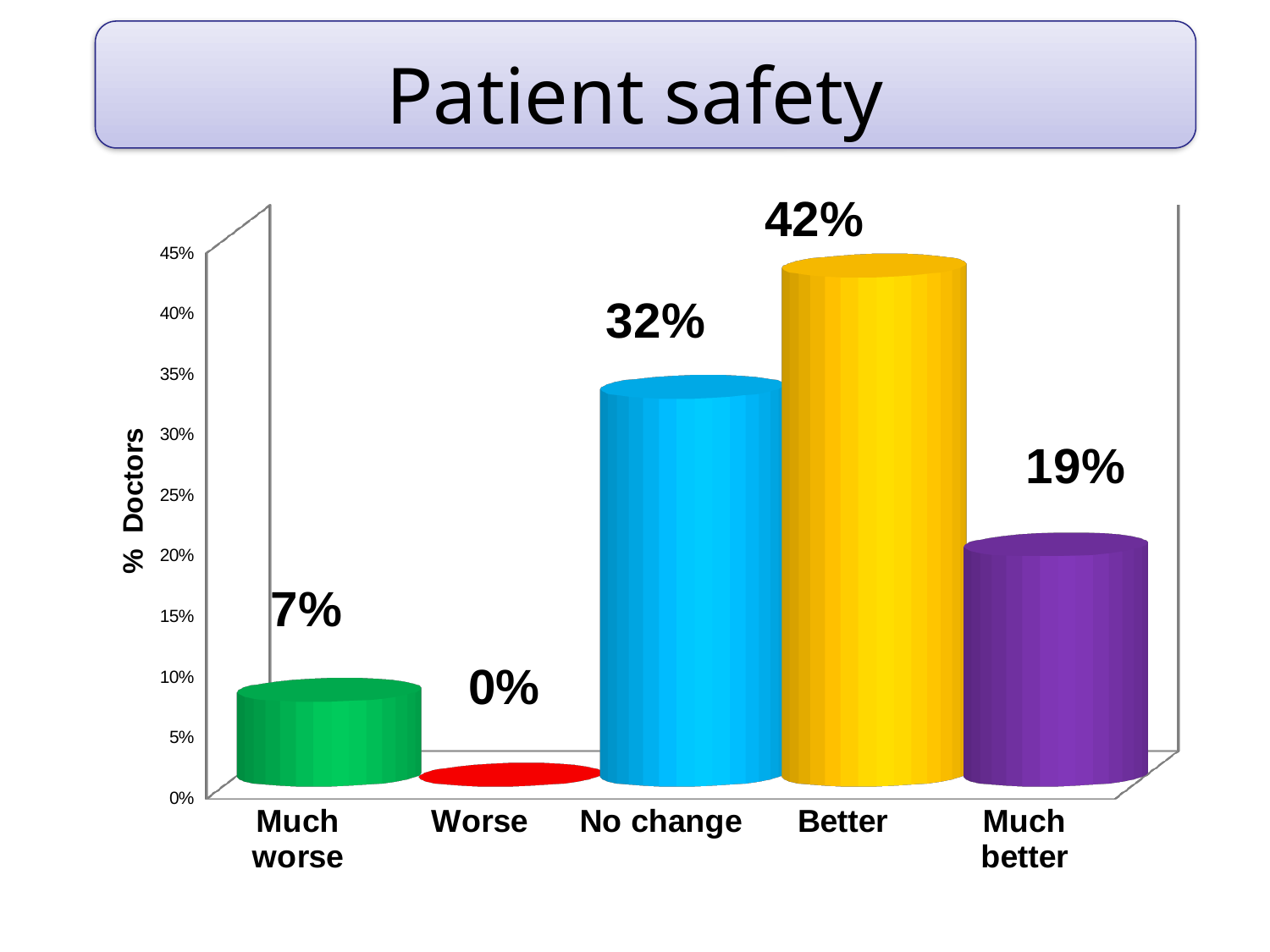
What is the value for No change? 32% What is the label on the vertical axis? % Doctors What is the value for Much better? 19% How many categories are shown on the x axis? 5 What kind of chart is shown on the slide? Bar chart What is the title of the slide? Patient safety Which category has the highest value? Better What is the difference between the values for Better and No change? 10% What is the value for Much worse? 7% What is the value for Better? 42% Which is larger, the value for Much better or the value for Much worse? Much better Which category has the lowest value? Worse